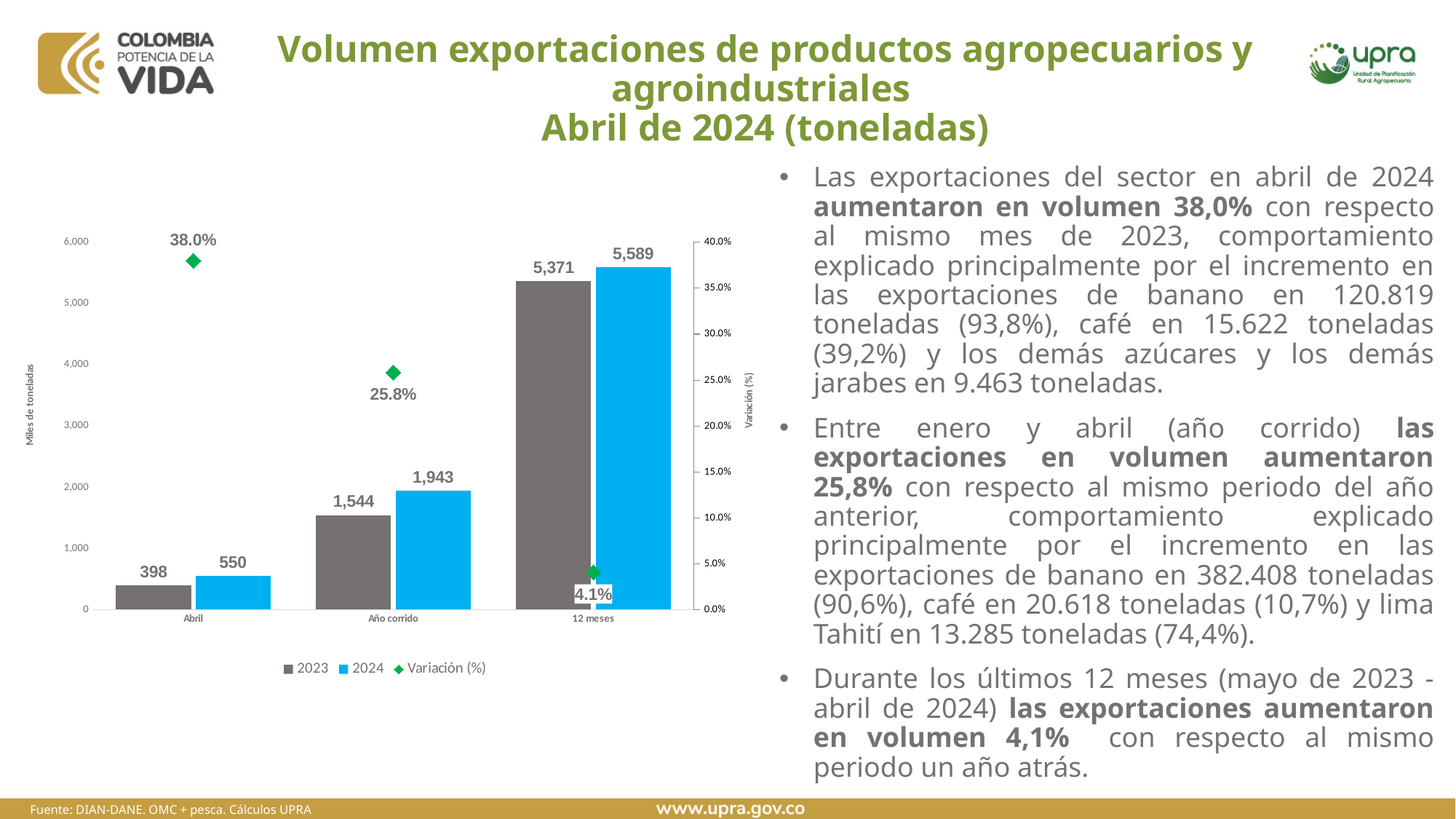
What is the 2023 value for Año corrido? 1,544 Which category has the lowest Variación (%) value? 12 meses What is the difference between the 2024 and 2023 values for 12 meses? 218 How many series does the legend list? 3 Which is larger, the 2023 value for Año corrido or the 2024 value for Abril? 2023 value for Año corrido What is the 2024 value for Abril? 550 What is the label of the left vertical axis? Miles de toneladas How many categories are shown on the x axis? 3 What is the Variación (%) value for 12 meses? 4.1% Which category has the highest 2024 value? 12 meses What kind of chart is used to show the 2023 and 2024 values? Bar chart What is the difference between the 2024 and 2023 values for Año corrido? 399